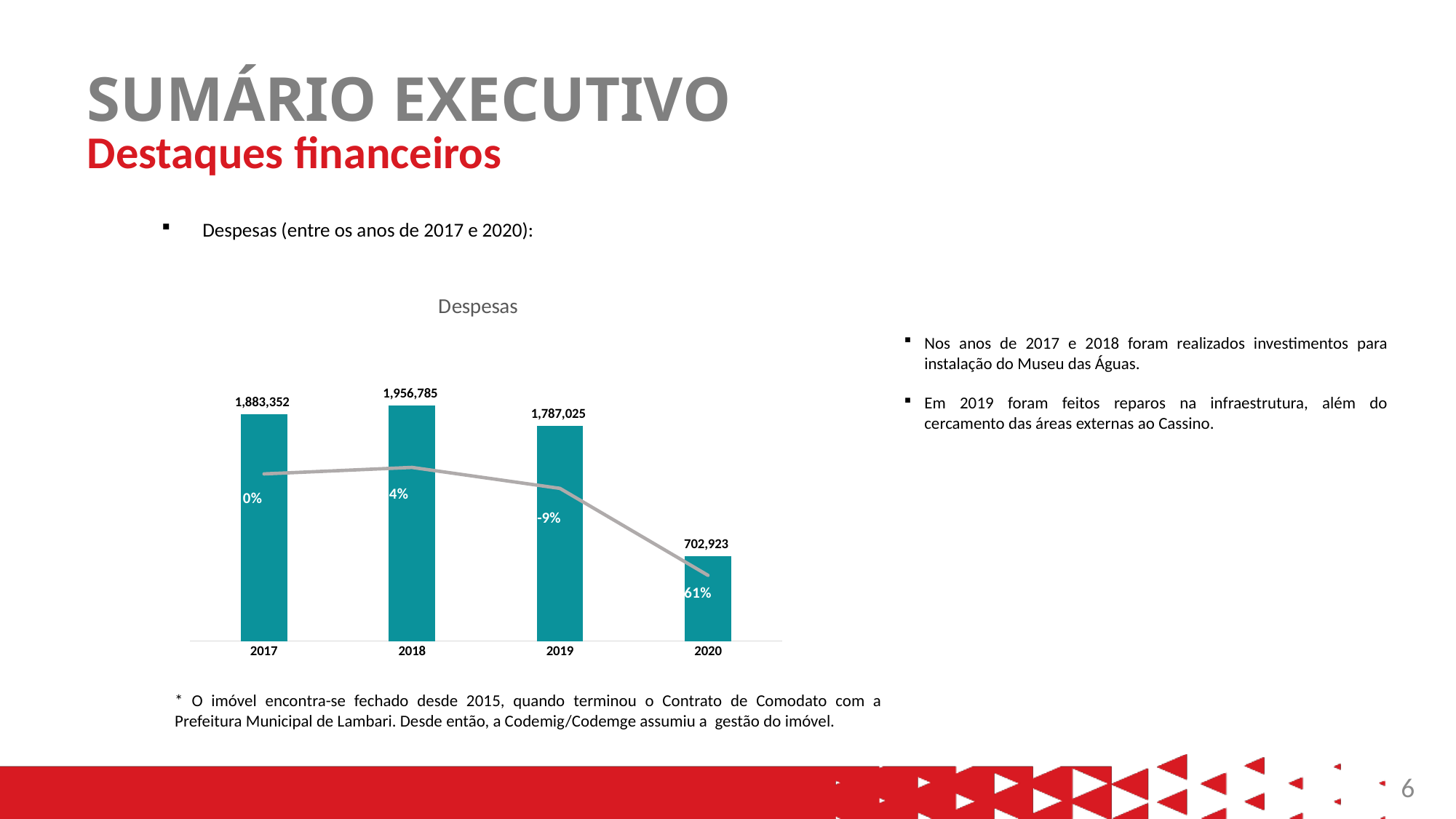
What type of chart is used to show the Despesas values by year? Bar chart What is the Despesas value for 2017? 1,883,352 Which year has the highest Despesas value? 2018 Which year has the lowest Despesas value? 2020 What is the Despesas value for 2019? 1,787,025 Which year has a larger Despesas value, 2019 or 2020? 2019 What is the difference between the Despesas values for 2018 and 2017? 73,433 What is the title of the chart? Despesas What percentage change is shown on the line for 2019? -9% What is the Despesas value for 2018? 1,956,785 What is the Despesas value for 2020? 702,923 How many years are shown on the x axis of the chart? 4